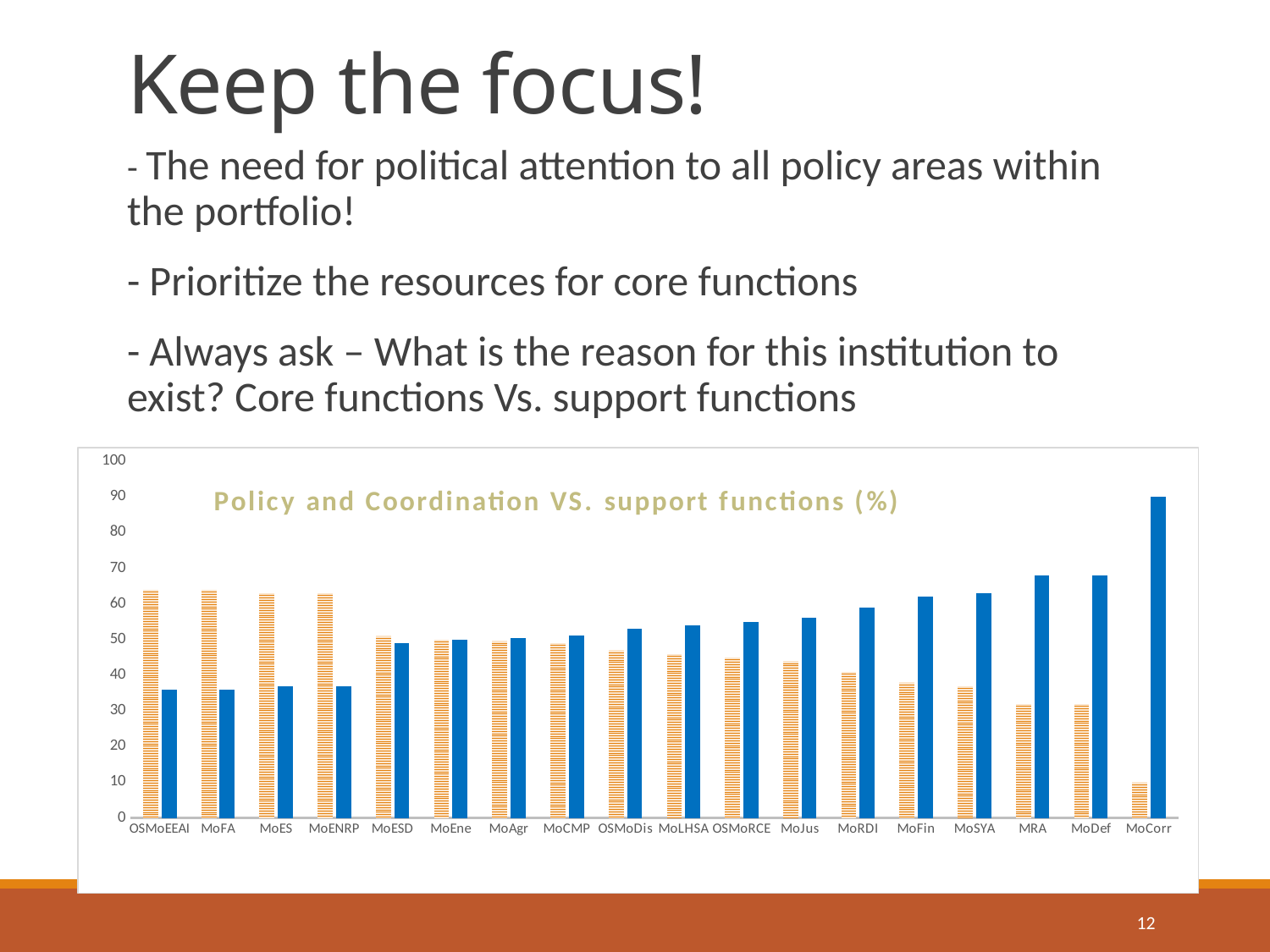
What is the title of the chart? Policy and Coordination VS. support functions (%) Which category has the highest blue (solid) bar? MoCorr Is the blue bar for MRA greater or less than 60? greater Is the orange bar for MoES greater or less than 50? greater For MoCorr, which bar is larger, the orange one or the blue one? blue Is the orange bar for MoFin greater or less than 40? less Which category has the lowest orange (striped) bar? MoCorr Do the blue bars generally rise or fall moving from left to right along the x axis? rise What kind of chart is shown on the slide? bar chart How many categories (institutions) are shown along the x axis of the chart? 18